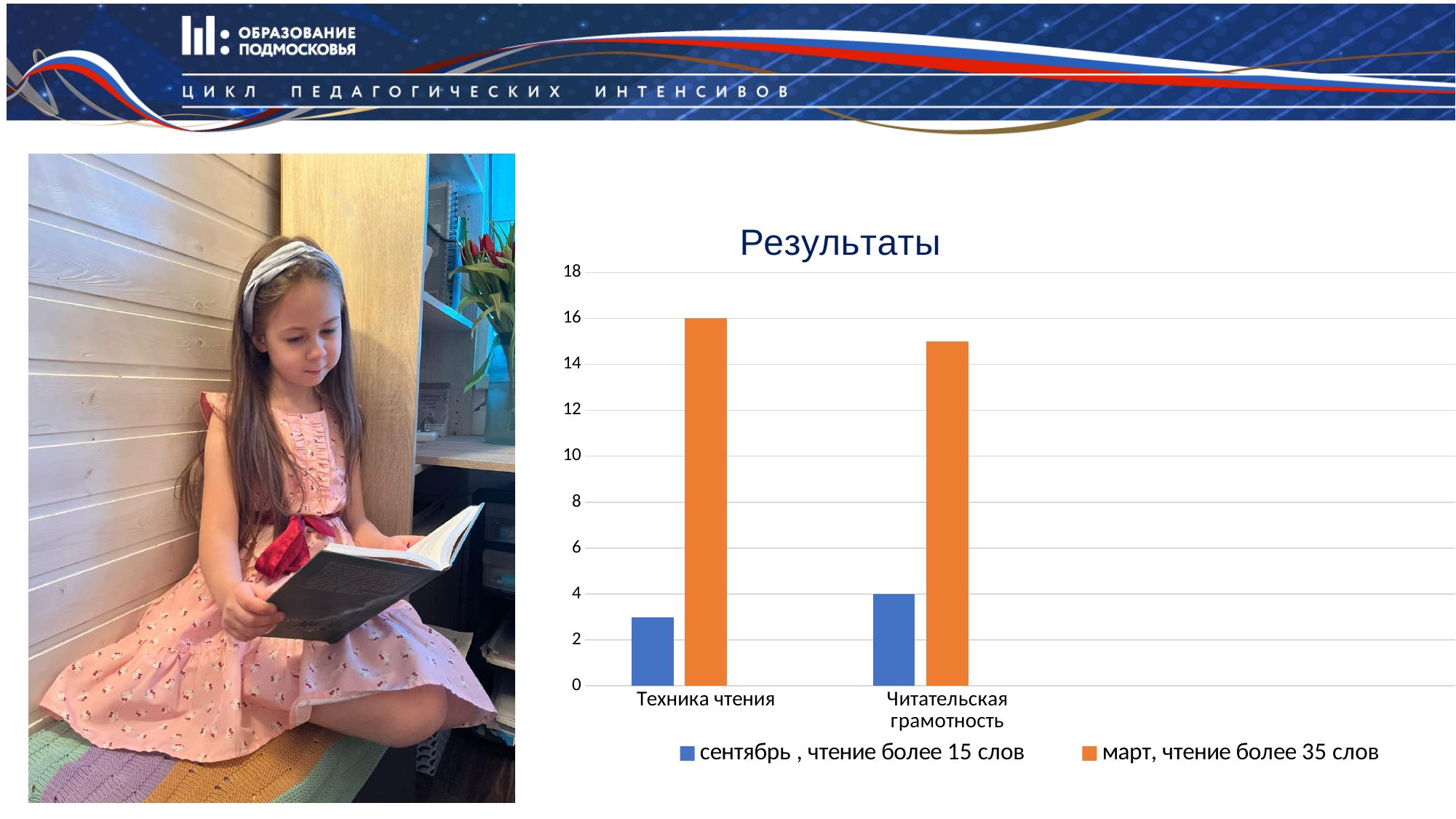
In the category 'Техника чтения', which series has the larger value: 'сентябрь , чтение более 15 слов' or 'март, чтение более 35 слов'? март, чтение более 35 слов What is the value for 'сентябрь , чтение более 15 слов' in the category 'Читательская грамотность'? 4 What is the title of the chart? Результаты What is the difference between the 'март, чтение более 35 слов' value for 'Техника чтения' and the 'сентябрь , чтение более 15 слов' value for 'Читательская грамотность'? 12 How many series does the chart legend list? 2 Is the value for 'март, чтение более 35 слов' in 'Читательская грамотность' greater or less than 14? greater Is the value for 'сентябрь , чтение более 15 слов' in 'Техника чтения' greater or less than 4? less What type of chart is shown on the slide? bar chart Which colour represents the series 'март, чтение более 35 слов' in the chart? orange What is the value for 'март, чтение более 35 слов' in the category 'Техника чтения'? 16 In the category 'Читательская грамотность', which series has the smaller value? сентябрь , чтение более 15 слов How many categories are shown on the x axis of the chart? 2